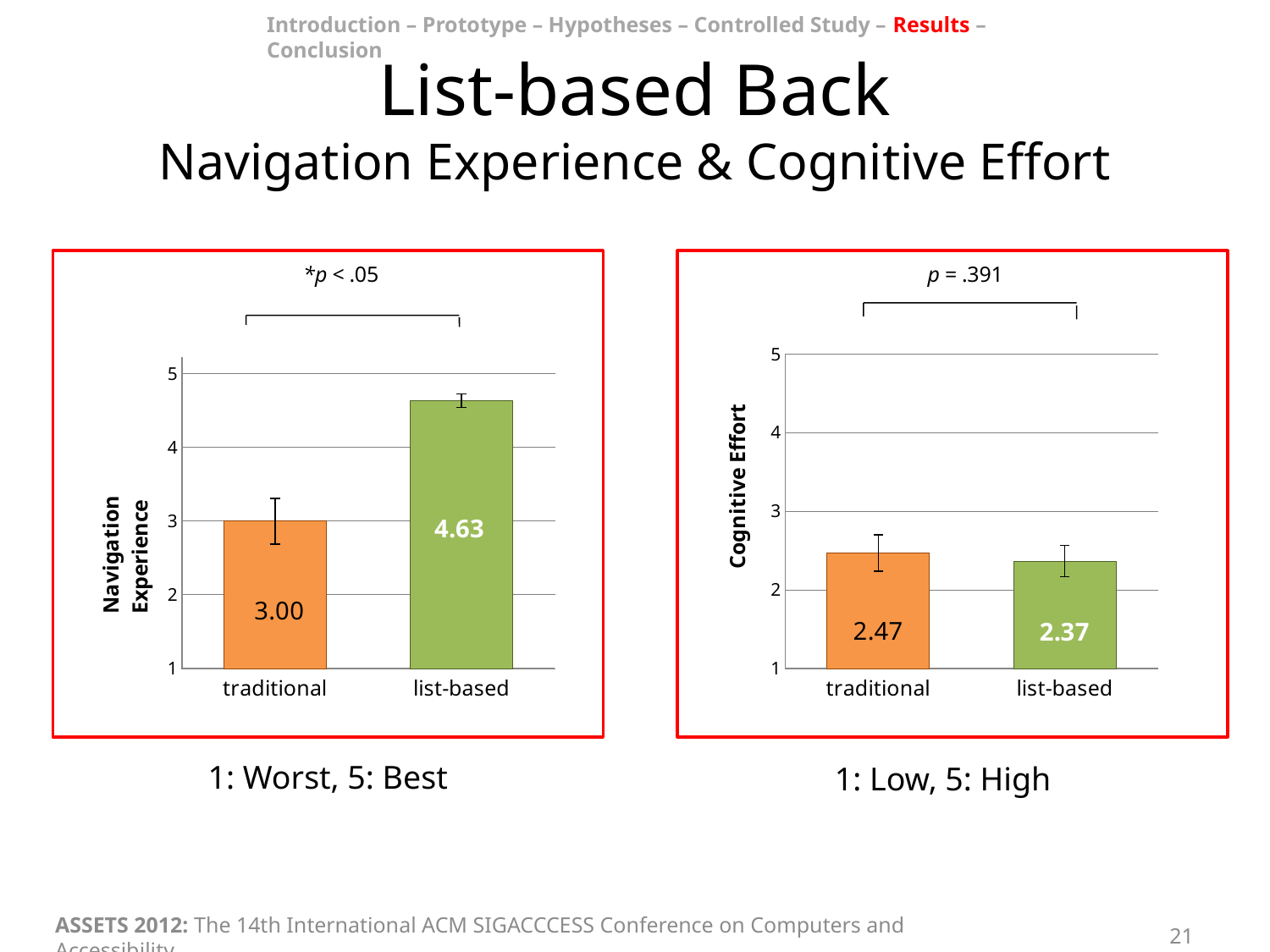
What is the y-axis label of the chart on the right? Cognitive Effort In the Navigation Experience chart on the left, which category has the highest value? list-based What kind of chart is the Navigation Experience chart on the left? bar chart In the Navigation Experience chart on the left, is the value for list-based greater or less than 4? greater How many categories are shown in the Cognitive Effort chart on the right? 2 In the Cognitive Effort chart on the right, what is the difference between the traditional and list-based values? 0.10 In the Navigation Experience chart on the left, what is the value for list-based? 4.63 In the Navigation Experience chart on the left, what is the value for traditional? 3.00 In the Cognitive Effort chart on the right, is the value for traditional greater or less than 3? less In the Cognitive Effort chart on the right, what is the value for traditional? 2.47 In the Cognitive Effort chart on the right, what is the value for list-based? 2.37 In the Navigation Experience chart on the left, what is the difference between the list-based and traditional values? 1.63